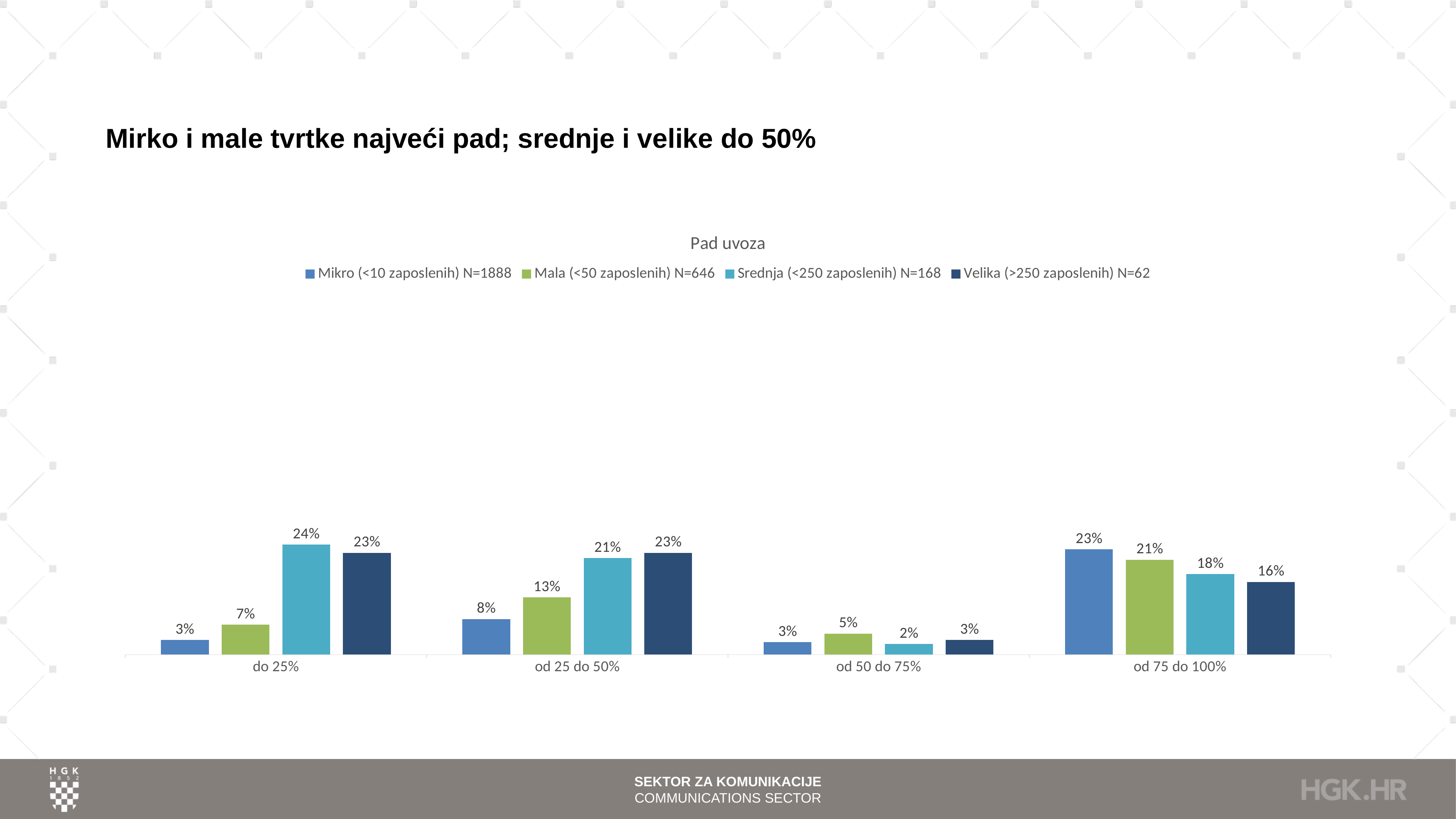
What is the value for Mala (<50 zaposlenih) N=646 in the 'od 50 do 75%' category? 5% What is the value for Velika (>250 zaposlenih) N=62 in the 'od 75 do 100%' category? 16% How many categories are shown on the x axis? 4 What is the difference between the Srednja and Mikro values in the 'do 25%' category? 21% What is the value for Mikro (<10 zaposlenih) N=1888 in the 'do 25%' category? 3% What is the title of the chart? Pad uvoza Which is larger in the 'od 25 do 50%' category: the Mala value or the Mikro value? Mala (<50 zaposlenih) N=646 Which series has the highest value in the 'do 25%' category? Srednja (<250 zaposlenih) N=168 What kind of chart is shown on the slide? Bar chart Which series has the lowest value in the 'od 75 do 100%' category? Velika (>250 zaposlenih) N=62 What is the value for Srednja (<250 zaposlenih) N=168 in the 'od 25 do 50%' category? 21% How many series does the legend list? 4